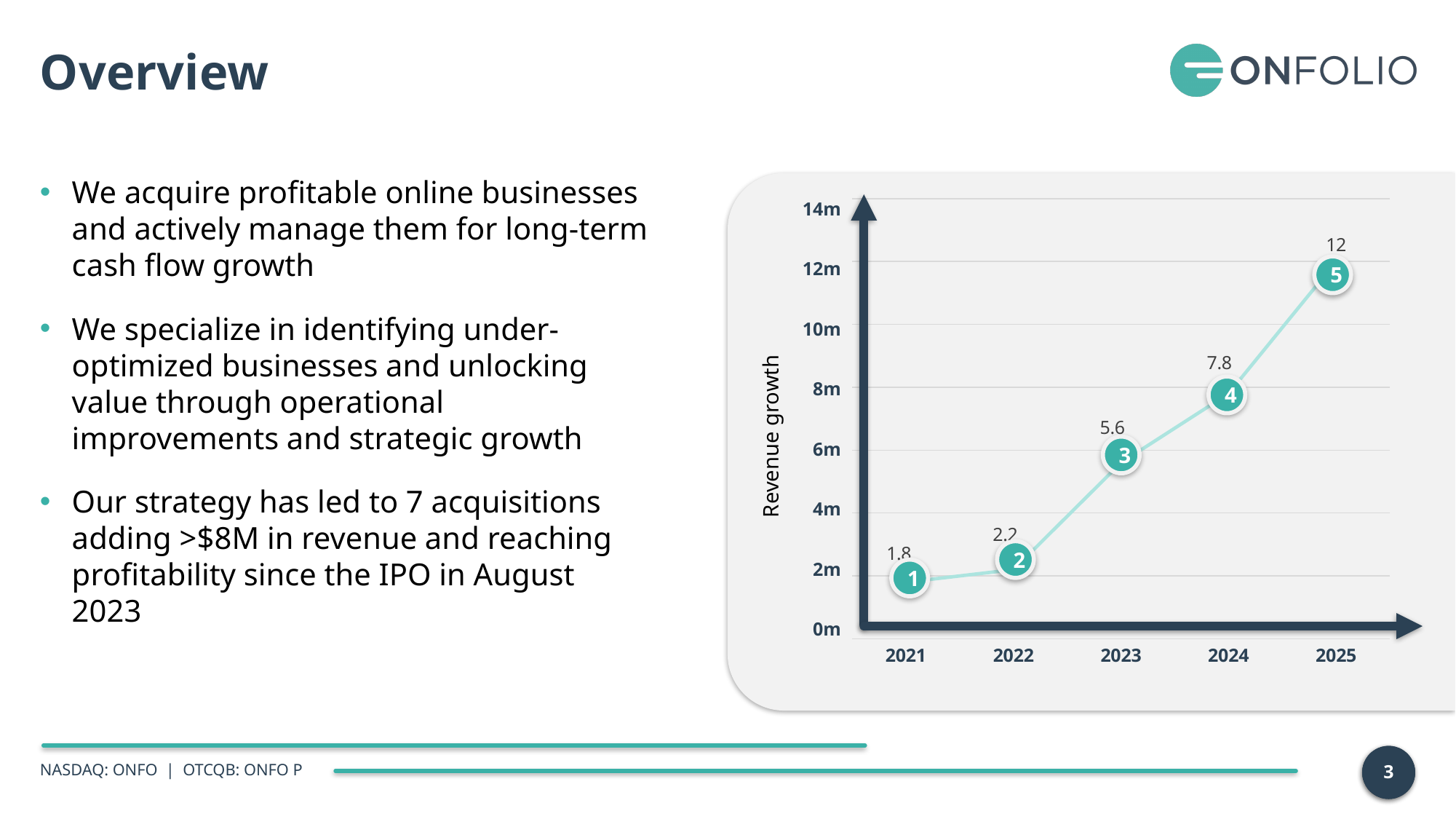
What is the difference between the values for 2024 and 2023? 2.2 Which year has the lowest revenue growth value? 2021 What is the revenue growth value for 2021? 1.8 Do the values rise or fall from 2021 to 2025? rise What kind of chart is shown on the slide? line chart Which is larger, the value for 2022 or the value for 2024? 2024 How many years are plotted on the chart? 5 What is the revenue growth value for 2023? 5.6 Is the value for 2025 greater or less than 10m? greater Which year has the highest revenue growth value? 2025 What is the revenue growth value for 2025? 12 What is the label on the vertical axis of the chart? Revenue growth